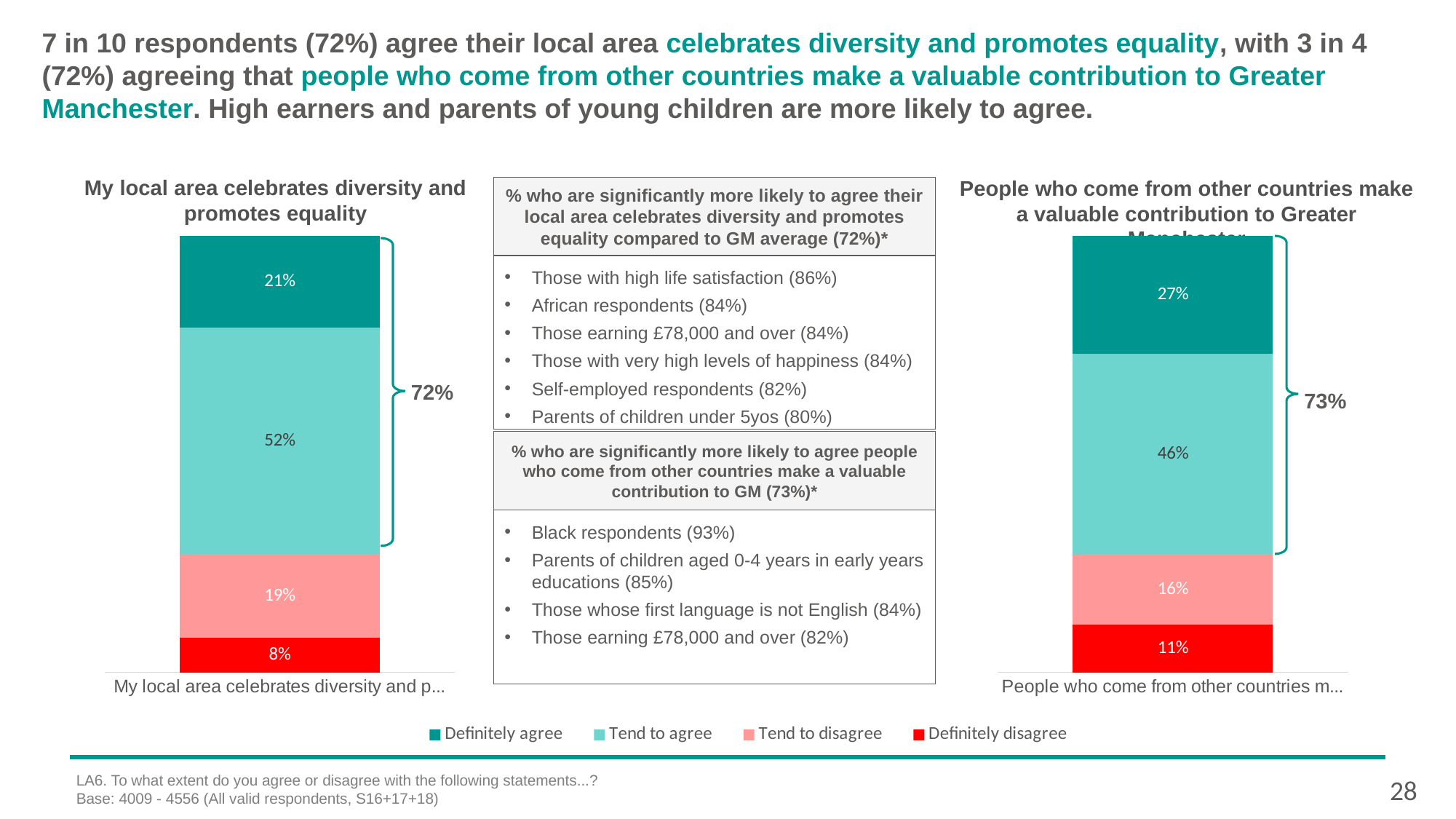
In the chart on the right about people who come from other countries making a valuable contribution to Greater Manchester, what percentage of respondents 'Definitely agree'? 27% In the chart on the right about people who come from other countries, which response category has the smallest share? Definitely disagree In the chart titled 'My local area celebrates diversity and promotes equality', what percentage of respondents 'Tend to agree'? 52% In the chart titled 'My local area celebrates diversity and promotes equality', what percentage of respondents 'Definitely disagree'? 8% Which chart has the higher 'Definitely agree' percentage: the left chart about the local area celebrating diversity, or the right chart about people from other countries? The right chart (people who come from other countries) In the chart on the right about people who come from other countries making a valuable contribution to Greater Manchester, what percentage of respondents 'Tend to disagree'? 16% What type of chart is used for 'My local area celebrates diversity and promotes equality'? Stacked bar chart In the chart titled 'My local area celebrates diversity and promotes equality', which response category has the largest share? Tend to agree How many series does the shared legend list for the two charts? 4 In the chart titled 'My local area celebrates diversity and promotes equality', what is the difference between the 'Tend to agree' and 'Definitely agree' percentages? 31 percentage points In the shared legend, which colour represents 'Definitely disagree'? Red In the chart on the right about people who come from other countries, what is the combined percentage of 'Definitely agree' and 'Tend to agree' shown by the bracket? 73%